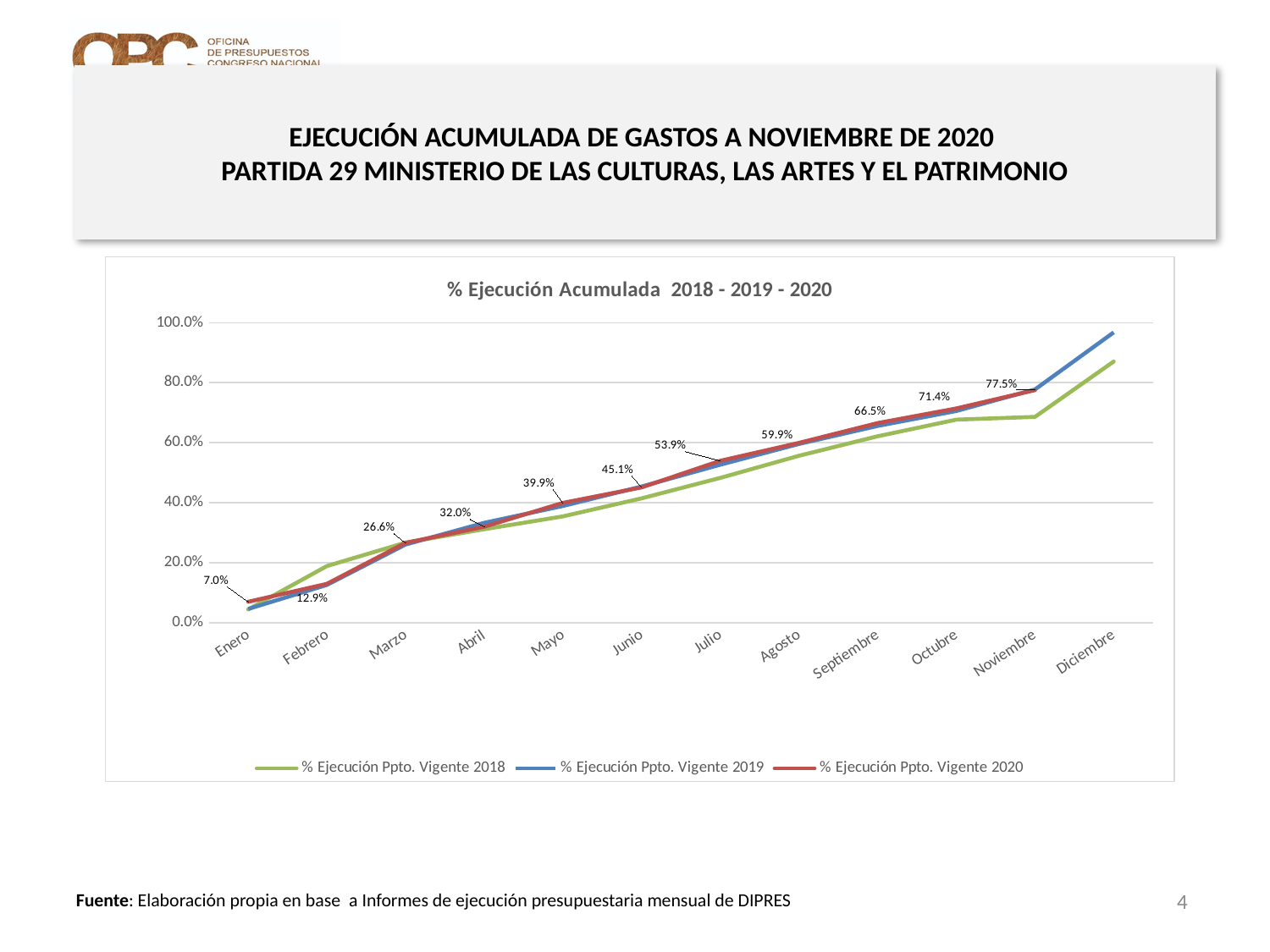
How many months are shown along the x axis? 12 What is the difference between the 2020 values for Noviembre and Octubre? 6.1% How many series does the legend list? 3 What kind of chart is shown on the slide? line chart Is the value for % Ejecución Ppto. Vigente 2019 in Diciembre greater or less than 80.0%? greater In Diciembre, which series is higher: % Ejecución Ppto. Vigente 2018 or % Ejecución Ppto. Vigente 2019? % Ejecución Ppto. Vigente 2019 What is the value for % Ejecución Ppto. Vigente 2020 in Noviembre? 77.5% What is the value for % Ejecución Ppto. Vigente 2020 in Julio? 53.9% What is the value for % Ejecución Ppto. Vigente 2020 in Enero? 7.0% Is the value for % Ejecución Ppto. Vigente 2018 in Noviembre greater or less than 80.0%? less What is the title of the chart? % Ejecución Acumulada 2018 - 2019 - 2020 Does the % Ejecución Ppto. Vigente 2020 line rise or fall from Enero to Noviembre? rise